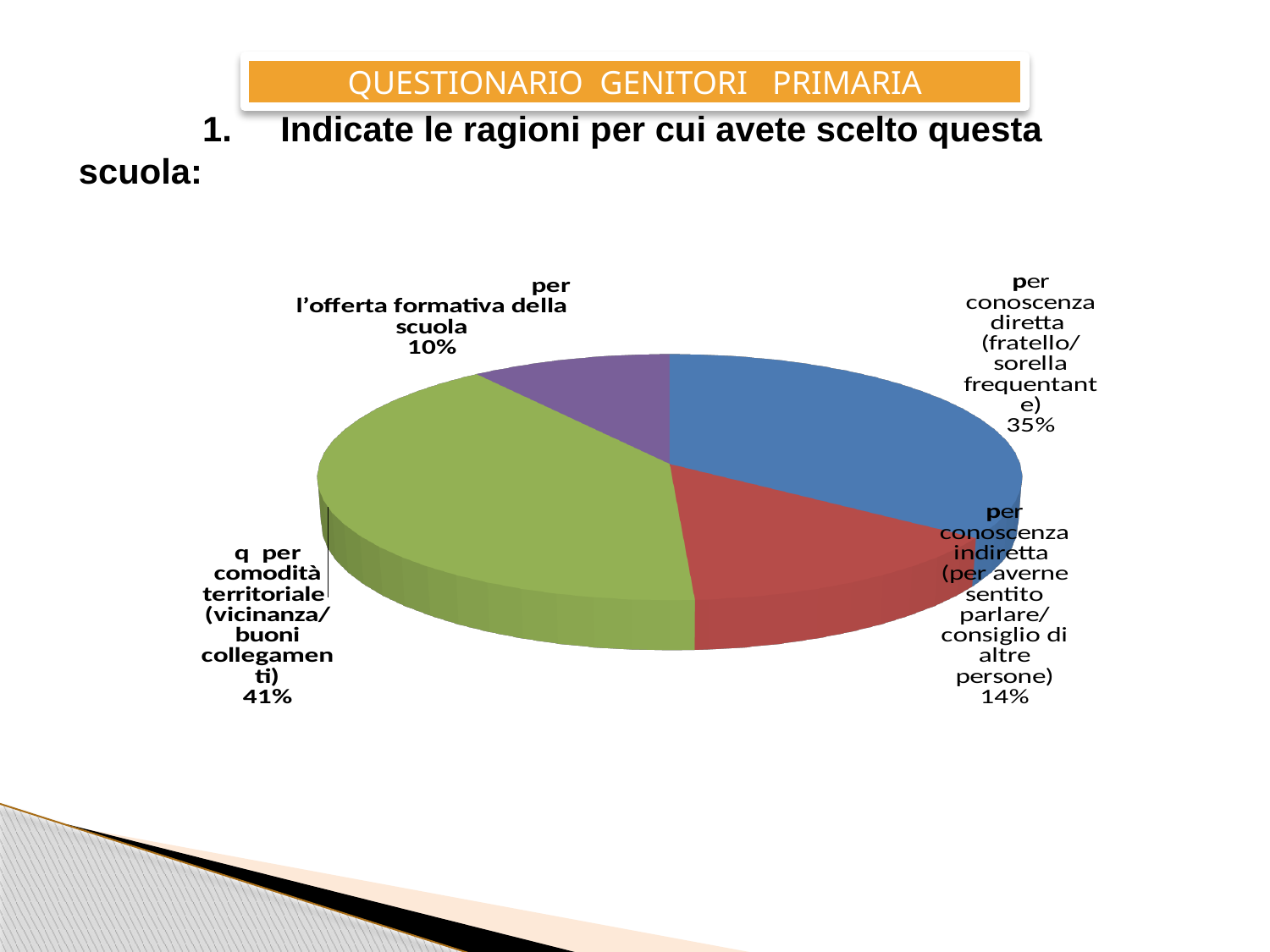
How many slices does the pie chart have? 4 What percentage is shown for 'conoscenza indiretta (per averne sentito parlare/consiglio di altre persone)'? 14% Which is larger: the share for 'conoscenza indiretta' or the share for 'l'offerta formativa della scuola'? conoscenza indiretta What is the difference in percentage points between 'comodità territoriale' and 'conoscenza diretta'? 6 Which reason has the smallest share of the pie? per l'offerta formativa della scuola What percentage is shown for 'l'offerta formativa della scuola'? 10% What colour is the slice for 'comodità territoriale'? green Which reason has the largest share of the pie? per comodità territoriale (vicinanza/buoni collegamenti) What is the combined share of 'conoscenza diretta' and 'conoscenza indiretta'? 49% What kind of chart is shown on the slide? pie chart What percentage is shown for 'conoscenza diretta (fratello/sorella frequentante)'? 35% What percentage of parents chose the school for 'comodità territoriale (vicinanza/buoni collegamenti)'? 41%